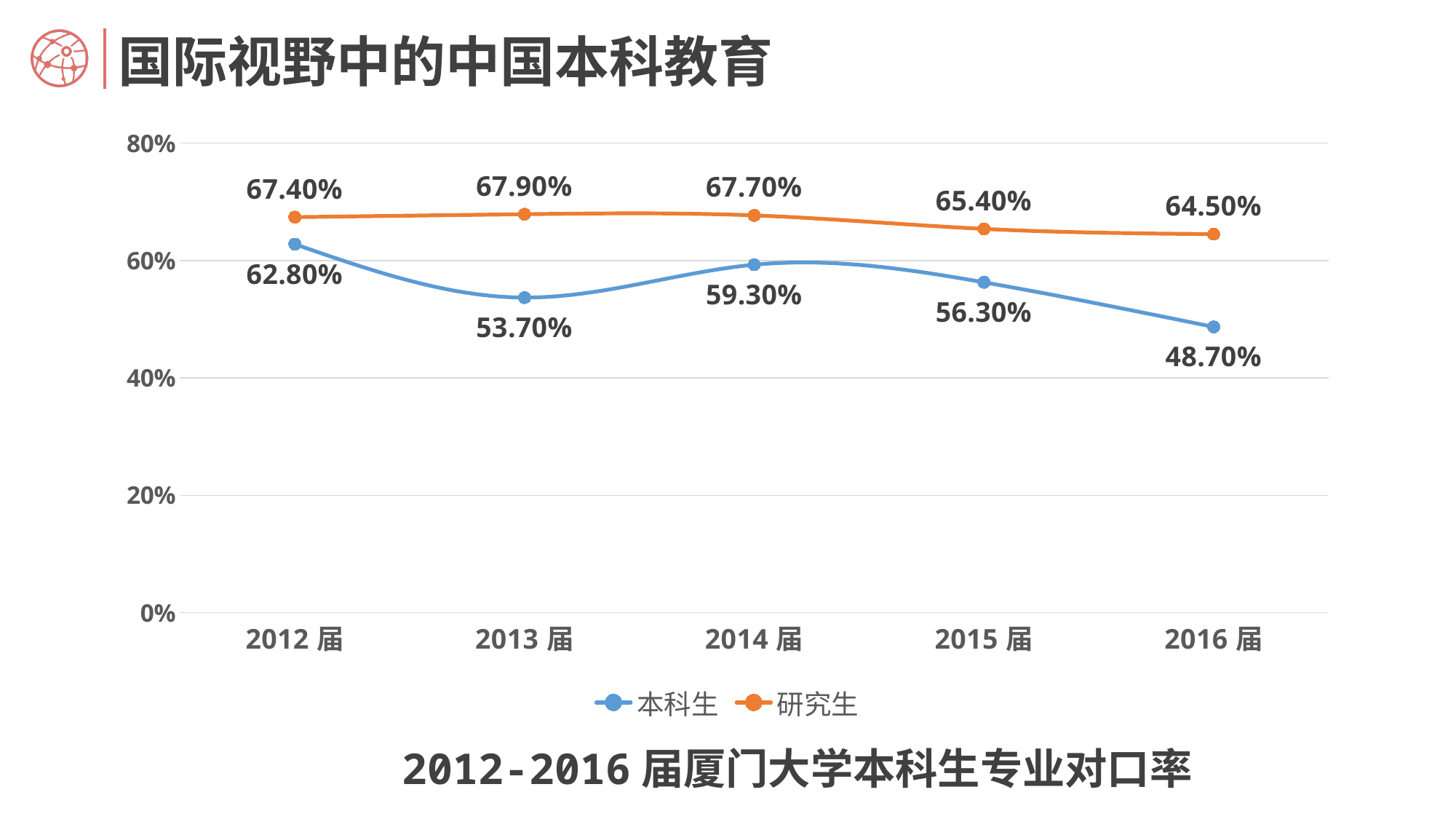
What is the difference between 研究生 and 本科生 in 2016 届? 15.80% What is the value for 研究生 in 2013 届? 67.90% Which is larger in 2012 届, 本科生 or 研究生? 研究生 How many years are shown on the x axis? 5 What kind of chart is this? Line chart Does the 研究生 series rise or fall from 2014 届 to 2016 届? Fall What is the value for 本科生 in 2014 届? 59.30% What is the value for 本科生 in 2016 届? 48.70% Which year has the highest value for 研究生? 2013 届 What is the title of the chart? 2012-2016 届厦门大学本科生专业对口率 Which year has the lowest value for 本科生? 2016 届 How many series does the legend list? 2